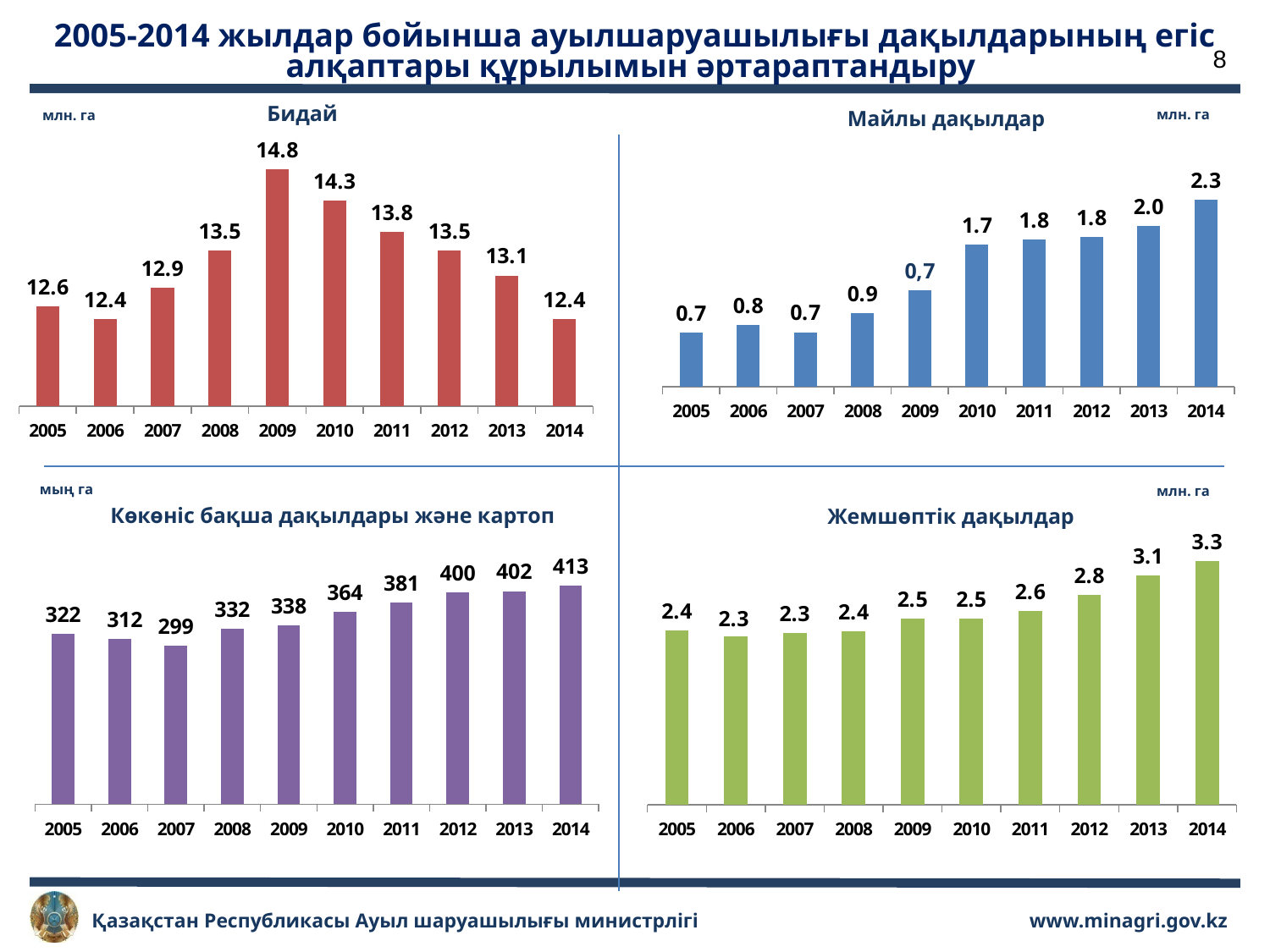
In the Бидай chart, what is the difference between the 2009 value and the 2014 value? 2.4 In the Көкөніс бақша дақылдары және картоп chart, what is the difference between the 2014 value and the 2005 value? 91 In the Жемшөптік дақылдар chart, which is larger, the value for 2012 or the value for 2013? 2013 In the Көкөніс бақша дақылдары және картоп chart, which year has the highest value? 2014 In the Майлы дақылдар chart, how many years are shown on the x axis? 10 In the Жемшөптік дақылдар chart, do the values generally rise or fall from 2008 to 2014? rise In the Көкөніс бақша дақылдары және картоп chart, what is the value for 2007? 299 In the Майлы дақылдар chart, what is the value for 2014? 2.3 In the Майлы дақылдар chart, which year has the highest value? 2014 In the Бидай chart, what is the value for 2009? 14.8 What type of chart is the Жемшөптік дақылдар chart? bar chart In the Бидай chart, which year has the lowest value? 2006 and 2014 (12.4)